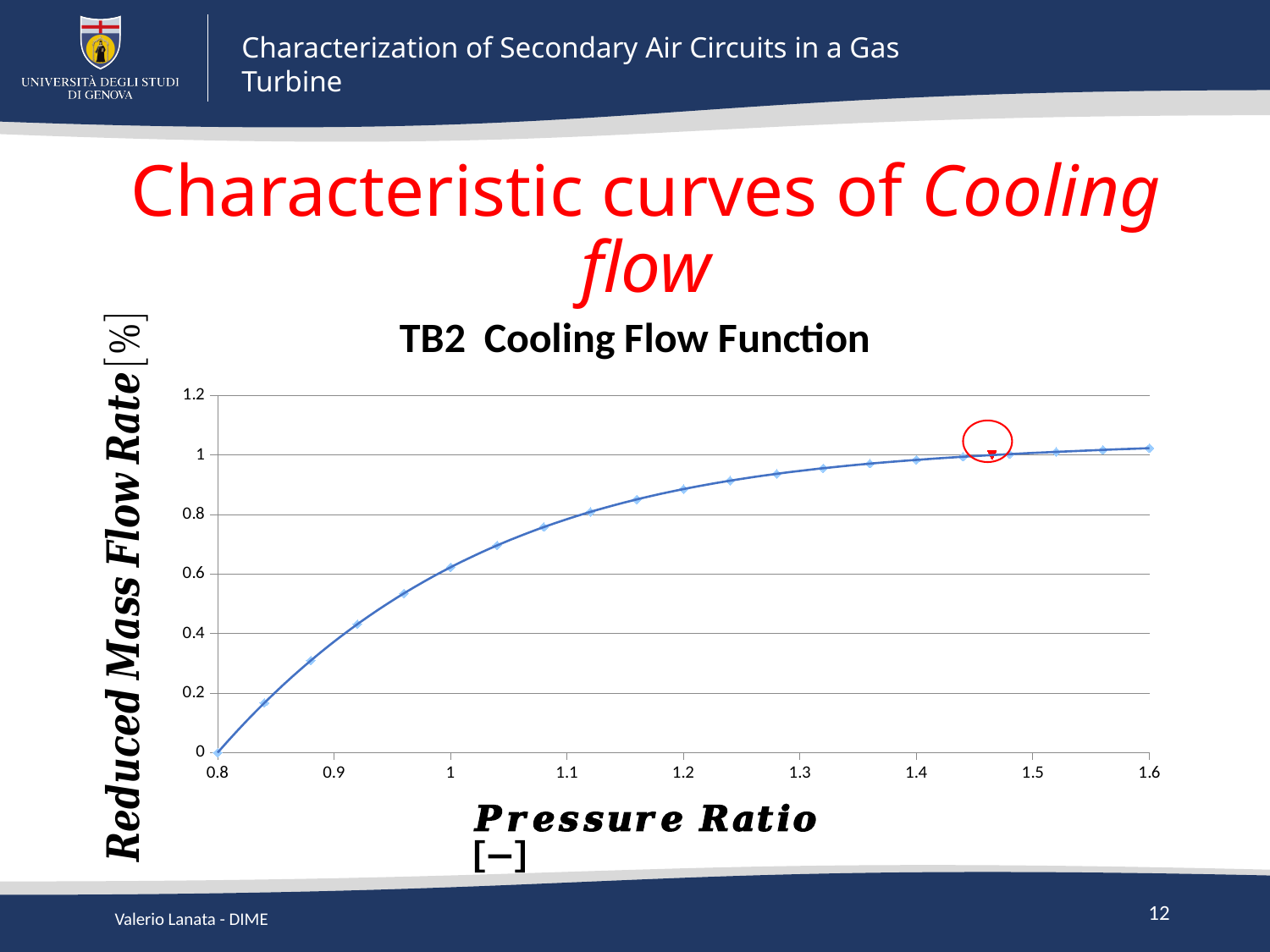
What is the Reduced Mass Flow Rate at a Pressure Ratio of 0.8? 0 What kind of chart is shown on the slide? line chart Is the Reduced Mass Flow Rate at a Pressure Ratio of 1.2 greater or less than 0.8? greater Is the Reduced Mass Flow Rate at a Pressure Ratio of 1 greater or less than 0.6? greater Which has the larger Reduced Mass Flow Rate, a Pressure Ratio of 1.1 or a Pressure Ratio of 1.3? 1.3 At which Pressure Ratio is the Reduced Mass Flow Rate lowest? 0.8 Does the Reduced Mass Flow Rate rise or fall as the Pressure Ratio increases from 0.8 to 1.6? rise At which Pressure Ratio is the Reduced Mass Flow Rate highest? 1.6 What is the title of the chart? TB2 Cooling Flow Function What is the label of the x axis? Pressure Ratio [-]